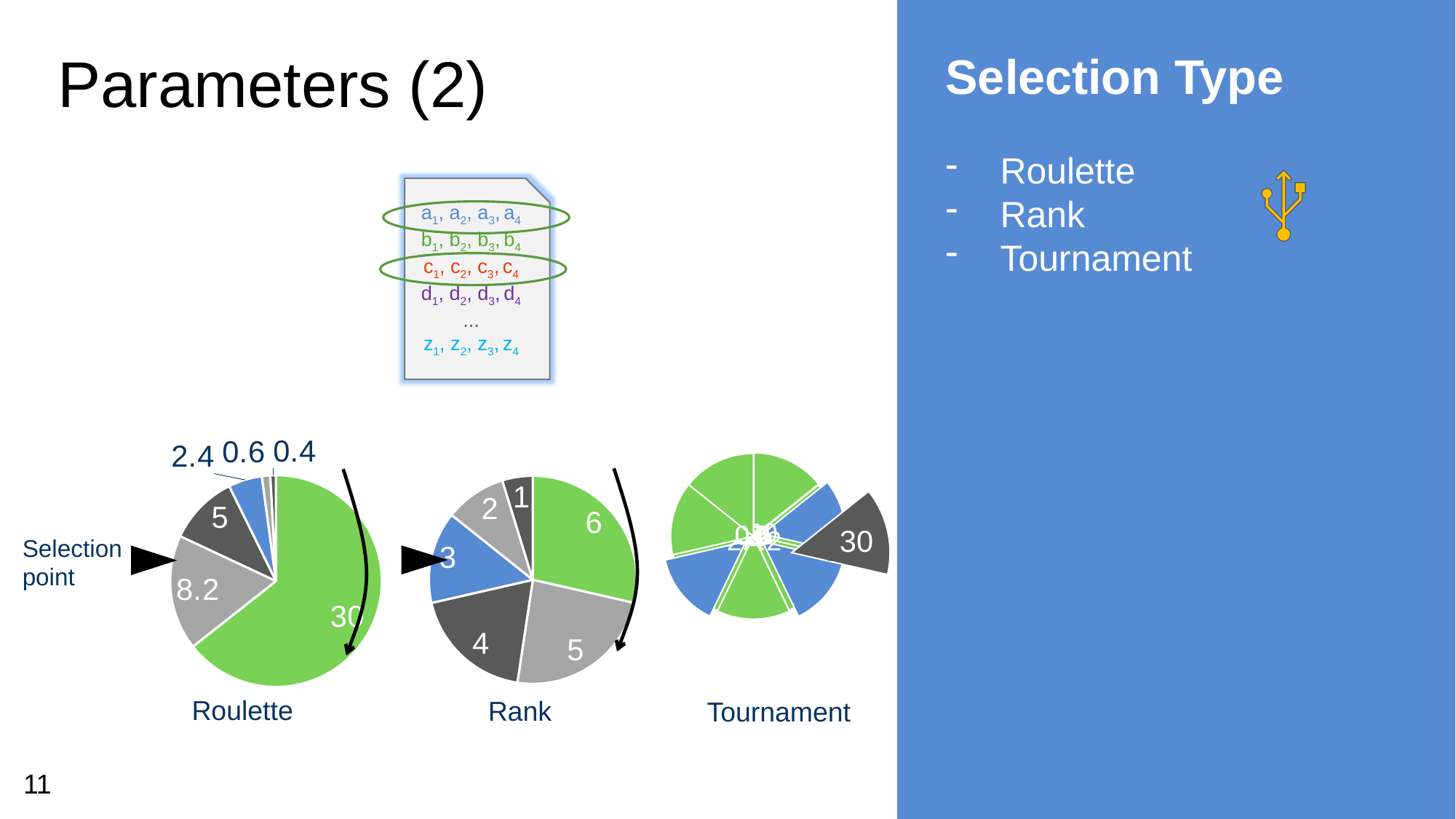
In the Rank pie chart, what is the value of the smallest slice? 1 How many slices does the Rank pie chart have? 6 In the Roulette pie chart, what is the value of the smallest slice? 0.4 In the Roulette pie chart, what is the difference between the largest slice (30) and the second-largest slice (8.2)? 21.8 How many slices does the Roulette pie chart have? 6 In the Rank pie chart, what is the difference between the largest slice and the smallest slice? 5 In the Tournament pie chart, what is the value of the dark grey slice that is pulled out from the pie? 30 What type of chart is the Roulette chart? pie chart In the Roulette pie chart, what is the value of the largest slice? 30 What are the labels of the three pie charts on the slide, from left to right? Roulette, Rank, Tournament In the Roulette pie chart, which is larger: the slice labelled 5 or the slice labelled 2.4? 5 In the Rank pie chart, what is the value of the largest slice? 6